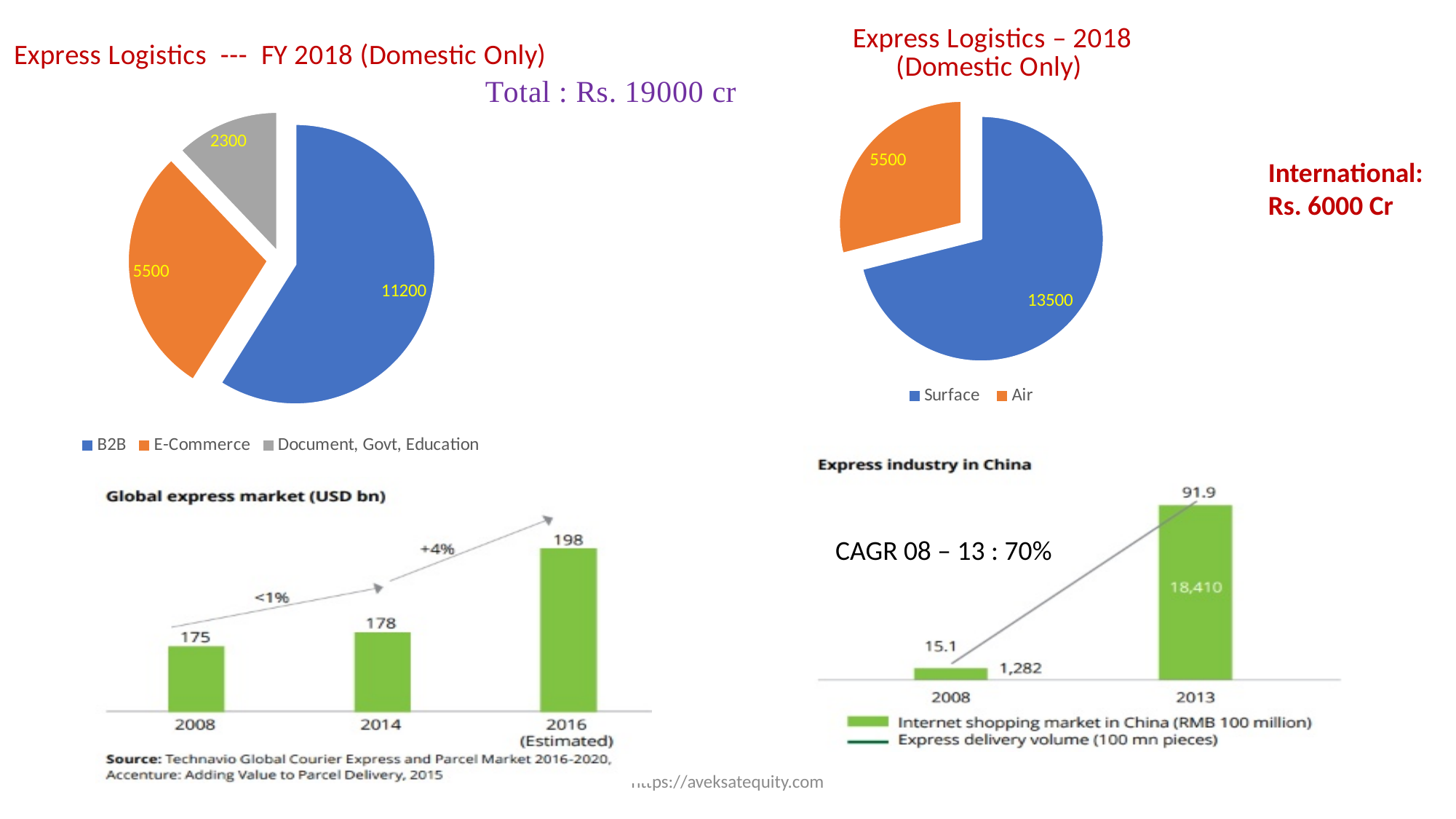
In the Express industry in China chart, what is the Express delivery volume for 2008? 15.1 In the top-left pie chart (Express Logistics FY 2018 Domestic Only), what is the value for B2B? 11200 In the Express industry in China chart, what is the Internet shopping market in China value for 2013? 18,410 In the top-left pie chart (Express Logistics FY 2018 Domestic Only), how many segments does the legend list? 3 In the top-left pie chart (Express Logistics FY 2018 Domestic Only), which segment is the smallest? Document, Govt, Education In the top-left pie chart (Express Logistics FY 2018 Domestic Only), what is the difference between the B2B and E-Commerce values? 5700 In the top-right pie chart (Express Logistics 2018 Domestic Only), what share of the total does Surface represent, given the total of Rs. 19000 cr? 71% In the Global express market (USD bn) chart, what is the value for 2014? 178 In the Global express market (USD bn) chart, do the values rise or fall from 2008 to 2016? rise In the Global express market (USD bn) chart, what is the difference between the 2016 (Estimated) and 2008 values? 23 In the top-right pie chart (Express Logistics 2018 Domestic Only), which is larger, Surface or Air? Surface In the top-right pie chart (Express Logistics 2018 Domestic Only), what is the value for Air? 5500